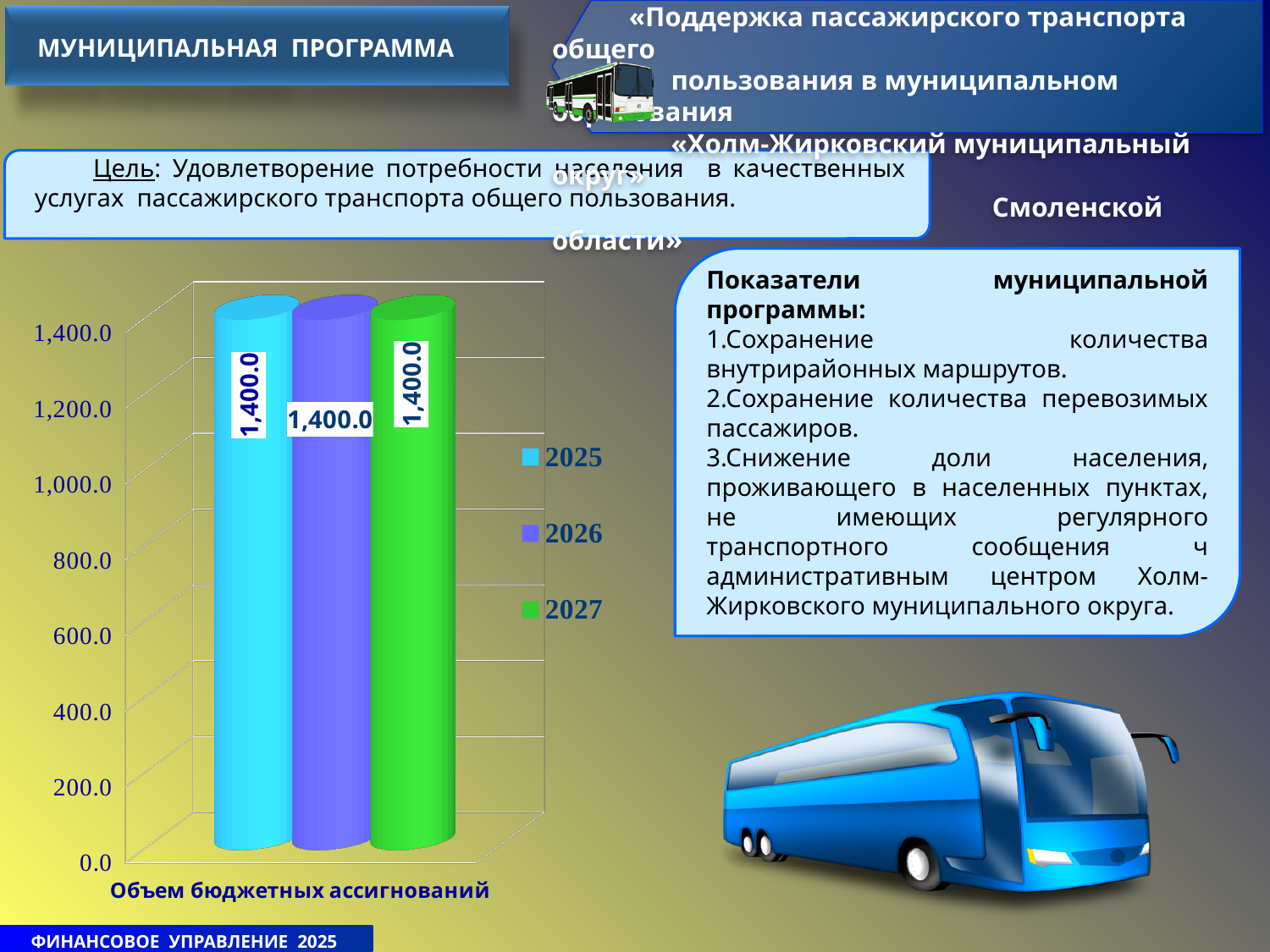
What is the label of the category on the x axis? Объем бюджетных ассигнований Is the value for 2025 greater or less than 1,000.0? greater What is the value for 2026 in the chart? 1,400.0 What is the difference between the values for 2025 and 2027? 0.0 How many categories are shown on the x axis of the chart? 1 What is the value for 2027 in the chart? 1,400.0 Is the value for 2026 greater or less than 1,200.0? greater Which colour represents 2027 in the legend? green What is the value for 2025 in the chart? 1,400.0 How many series does the legend list? 3 Do the values rise, fall or stay the same from 2025 to 2027? stay the same What kind of chart is shown on the slide? bar chart